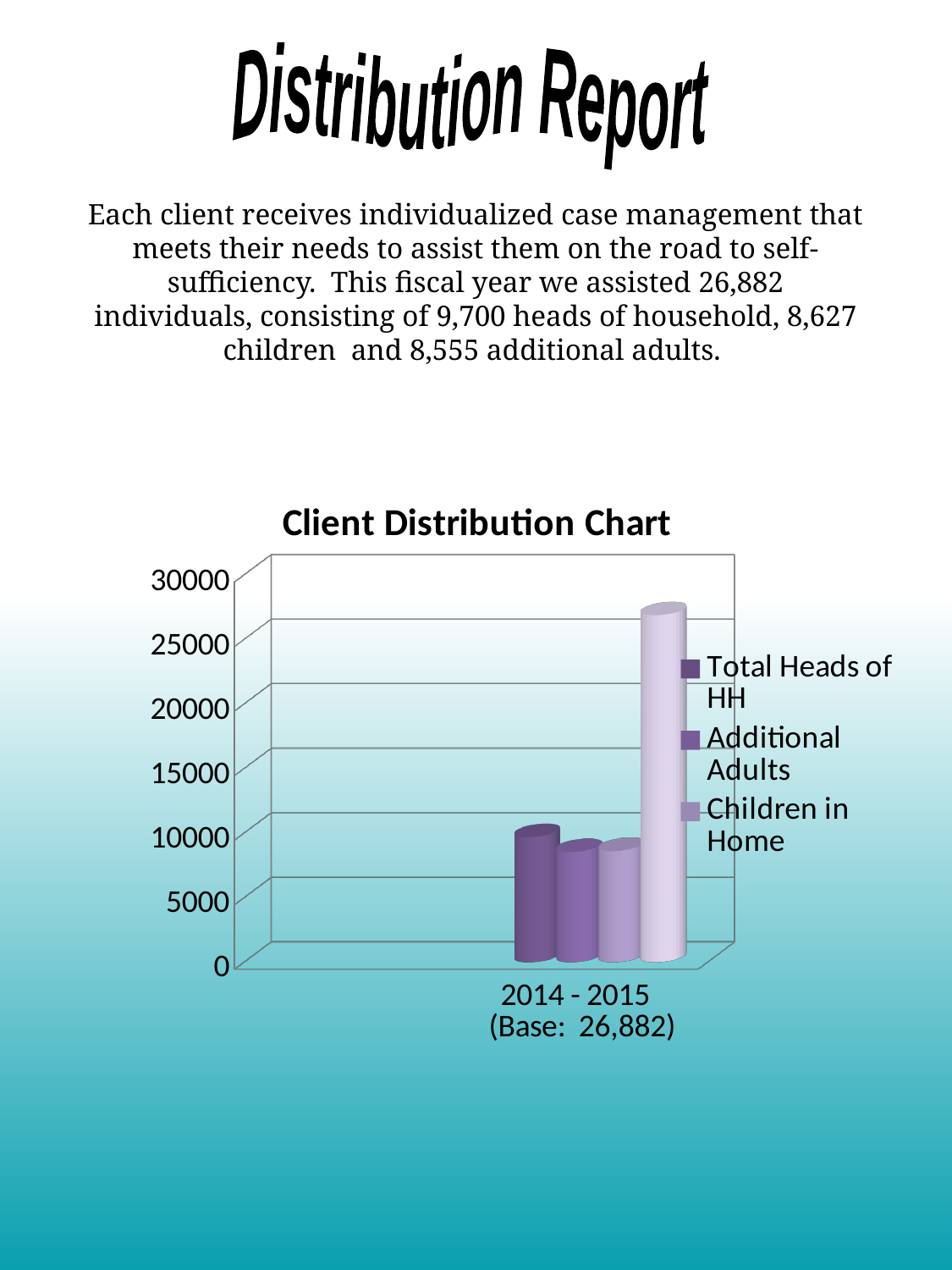
How many series does the chart's legend list? 3 Among the three series listed in the legend, which has the highest value? Total Heads of HH What are the three series listed in the chart's legend? Total Heads of HH, Additional Adults, Children in Home What is the highest value shown on the chart's vertical axis? 30000 Is the value of the tallest bar in the chart greater or less than 25000? greater Which is larger, the value for Total Heads of HH or the value for Additional Adults? Total Heads of HH Is the value for Children in Home greater or less than 10000? less How many categories are shown on the x axis of the chart? 1 What is the category label on the x axis of the chart? 2014 - 2015 (Base: 26,882) What is the title of the chart? Client Distribution Chart What kind of chart is shown on the slide? bar chart Is the value for Additional Adults greater or less than 10000? less